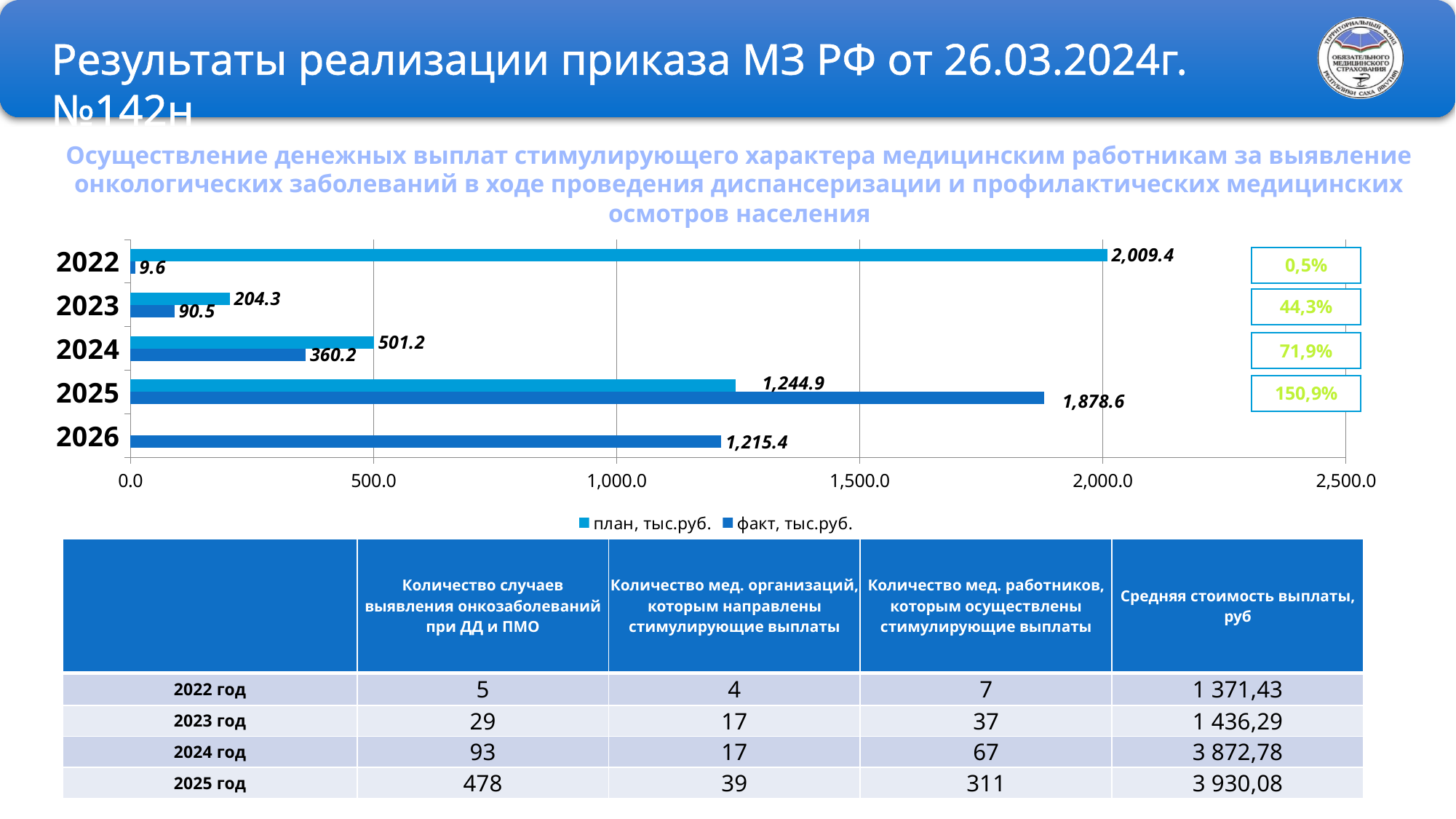
What is the факт, тыс.руб. value for 2023? 90.5 Which year has the lowest факт, тыс.руб. value? 2022 How many years are shown on the chart's vertical axis? 5 What type of chart is shown on the slide? bar chart For 2025, which is larger: the план value or the факт value? факт Which year has the highest план, тыс.руб. value? 2022 What is the план, тыс.руб. value for 2024? 501.2 How many series does the chart legend list? 2 What is the факт, тыс.руб. value for 2025? 1,878.6 What is the план, тыс.руб. value for 2022? 2,009.4 Is the факт, тыс.руб. value for 2026 greater or less than 1,000.0? greater What is the difference between the план and факт values for 2024? 141.0